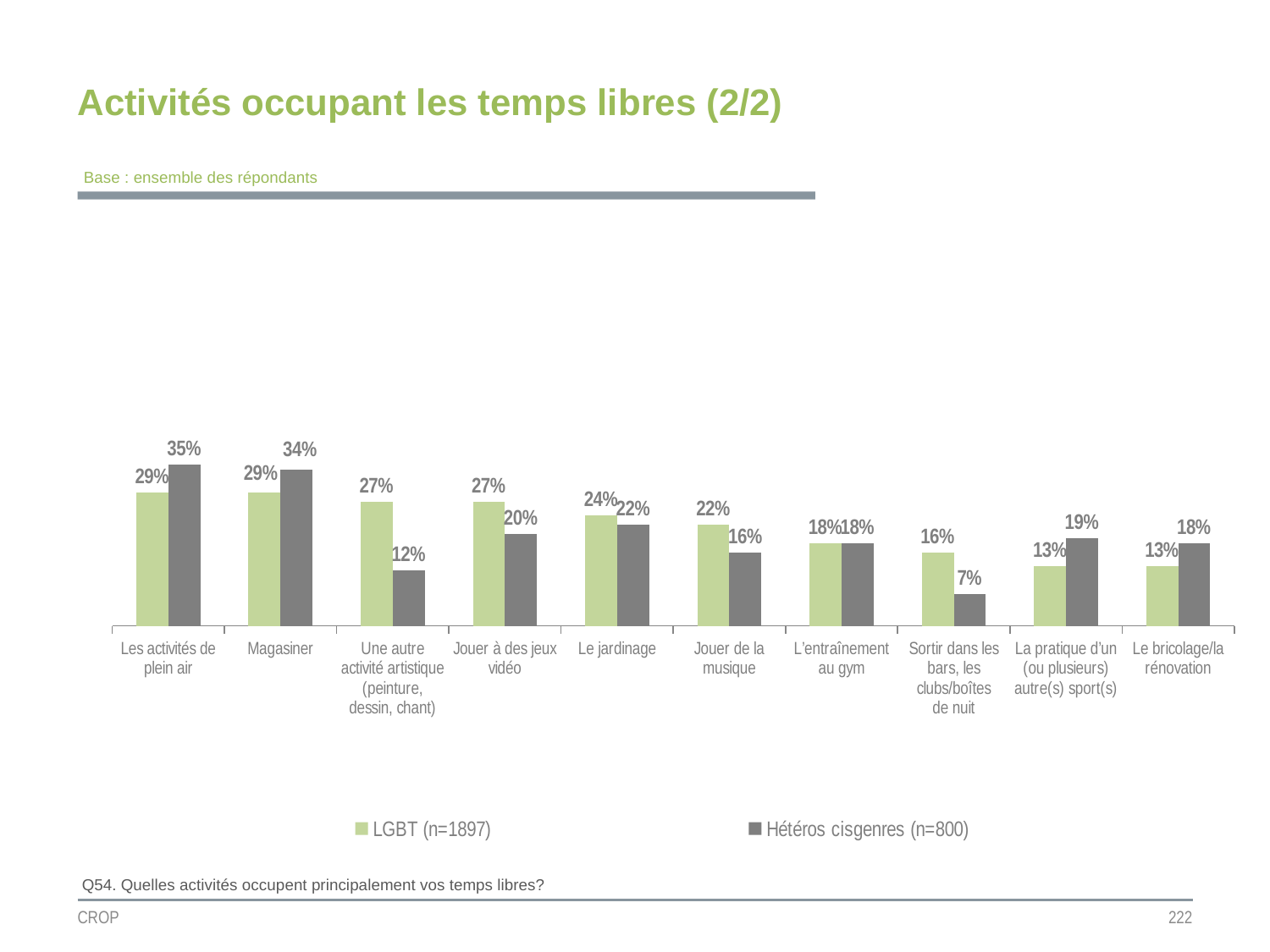
How many activity categories are shown on the chart? 10 Which series has the larger value for 'Jouer de la musique'? LGBT (n=1897) Which series has the larger value for 'La pratique d'un (ou plusieurs) autre(s) sport(s)'? Hétéros cisgenres (n=800) What is the difference between the LGBT (n=1897) and Hétéros cisgenres (n=800) values for 'Une autre activité artistique (peinture, dessin, chant)'? 15% Which category has the lowest value for Hétéros cisgenres (n=800)? Sortir dans les bars, les clubs/boîtes de nuit How many series does the legend list? 2 Which category has the highest value for Hétéros cisgenres (n=800)? Les activités de plein air What kind of chart is shown on the slide? Bar chart What is the value for LGBT (n=1897) for 'Une autre activité artistique (peinture, dessin, chant)'? 27% What is the difference between the Hétéros cisgenres (n=800) and LGBT (n=1897) values for 'Les activités de plein air'? 6% What is the value for Hétéros cisgenres (n=800) for 'Sortir dans les bars, les clubs/boîtes de nuit'? 7% What is the value for Hétéros cisgenres (n=800) for 'Le jardinage'? 22%